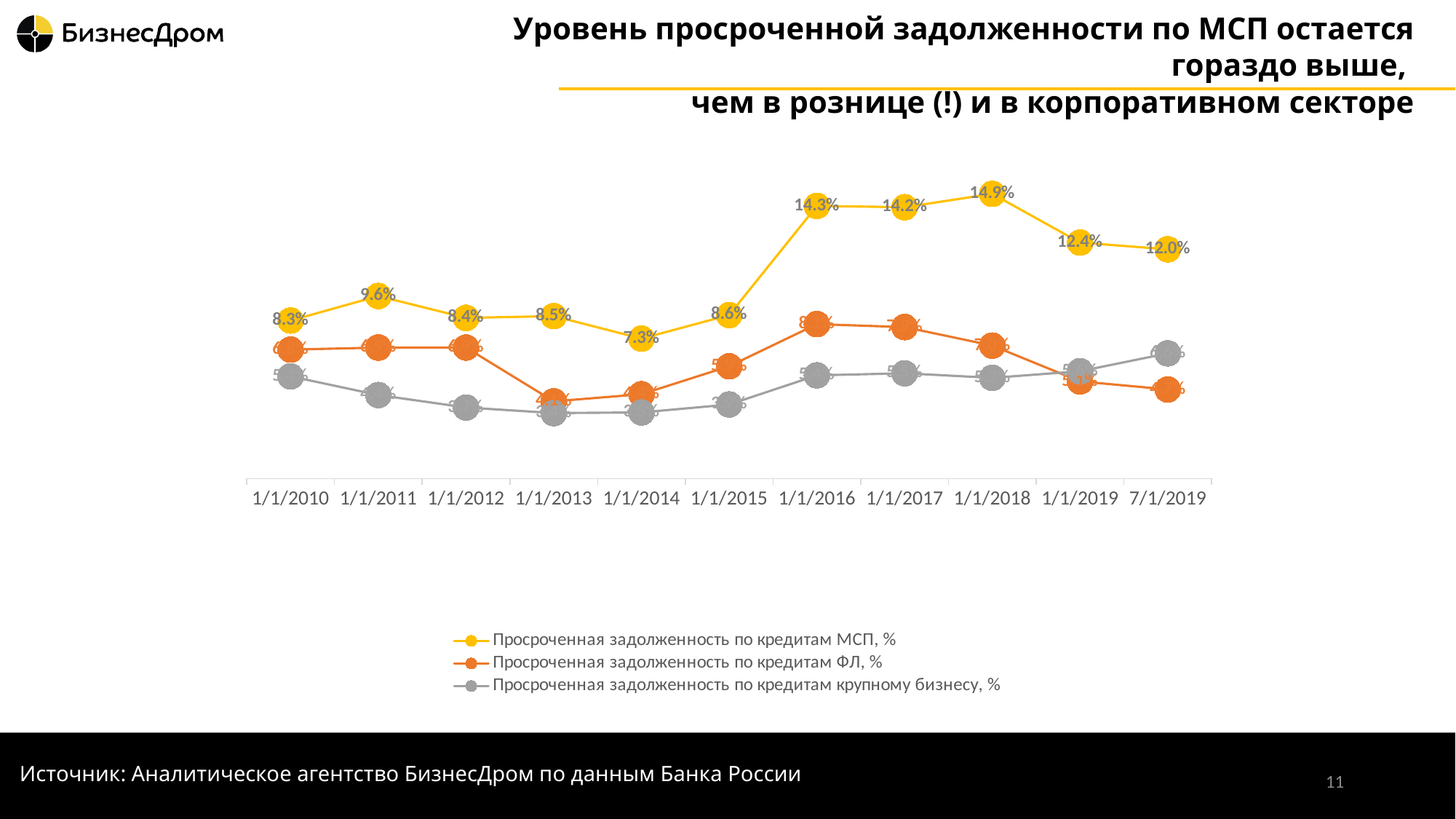
On which date is 'Просроченная задолженность по кредитам МСП, %' highest? 1/1/2018 What is the value of 'Просроченная задолженность по кредитам МСП, %' on 1/1/2010? 8.3% What is the value of 'Просроченная задолженность по кредитам МСП, %' on 1/1/2018? 14.9% What is the difference between the МСП values on 1/1/2016 and 1/1/2015? 5.7% What colour is the line for 'Просроченная задолженность по кредитам крупному бизнесу, %'? gray How many series does the legend list? 3 What type of chart is shown on the slide? line chart What is the value of 'Просроченная задолженность по кредитам МСП, %' on 7/1/2019? 12.0% How many dates are shown on the x axis? 11 On which date is 'Просроченная задолженность по кредитам МСП, %' lowest? 1/1/2014 Does 'Просроченная задолженность по кредитам МСП, %' rise or fall from 1/1/2018 to 7/1/2019? fall Which series has the highest value on 1/1/2017? Просроченная задолженность по кредитам МСП, %